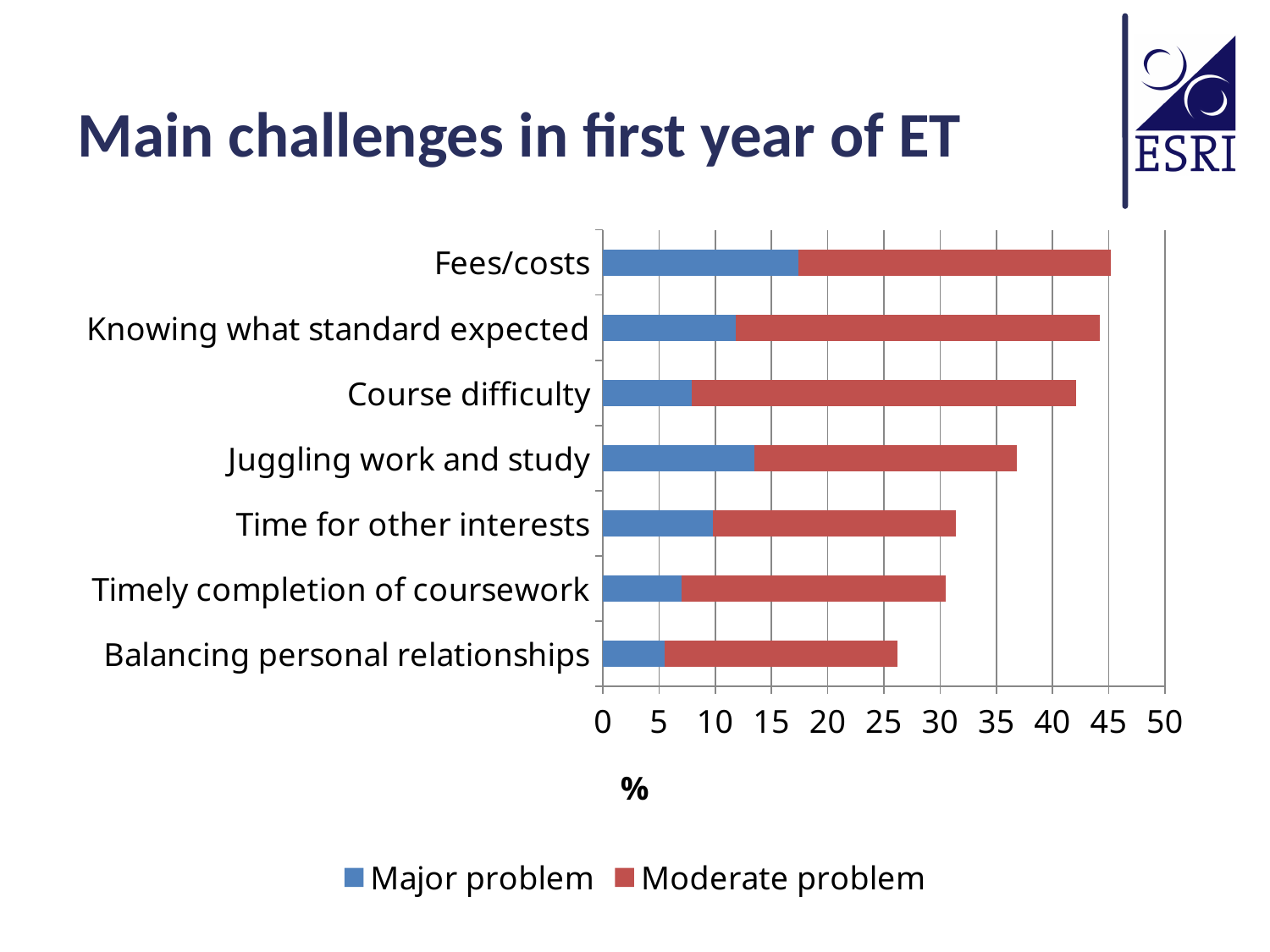
Which has the larger Major problem value: Fees/costs or Course difficulty? Fees/costs What are the two series named in the legend? Major problem and Moderate problem Is the total bar for Balancing personal relationships greater or less than 30? less Is the Major problem value for Fees/costs greater or less than 15? greater Which has the larger Major problem value: Juggling work and study or Time for other interests? Juggling work and study Which challenge has the shortest total bar (Major plus Moderate problem)? Balancing personal relationships How many challenge categories are plotted on the chart? 7 How many series does the legend list? 2 Is the Major problem value for Course difficulty greater or less than 10? less What kind of chart is shown on the slide? Stacked bar chart Which challenge has the longest total bar (Major plus Moderate problem)? Fees/costs